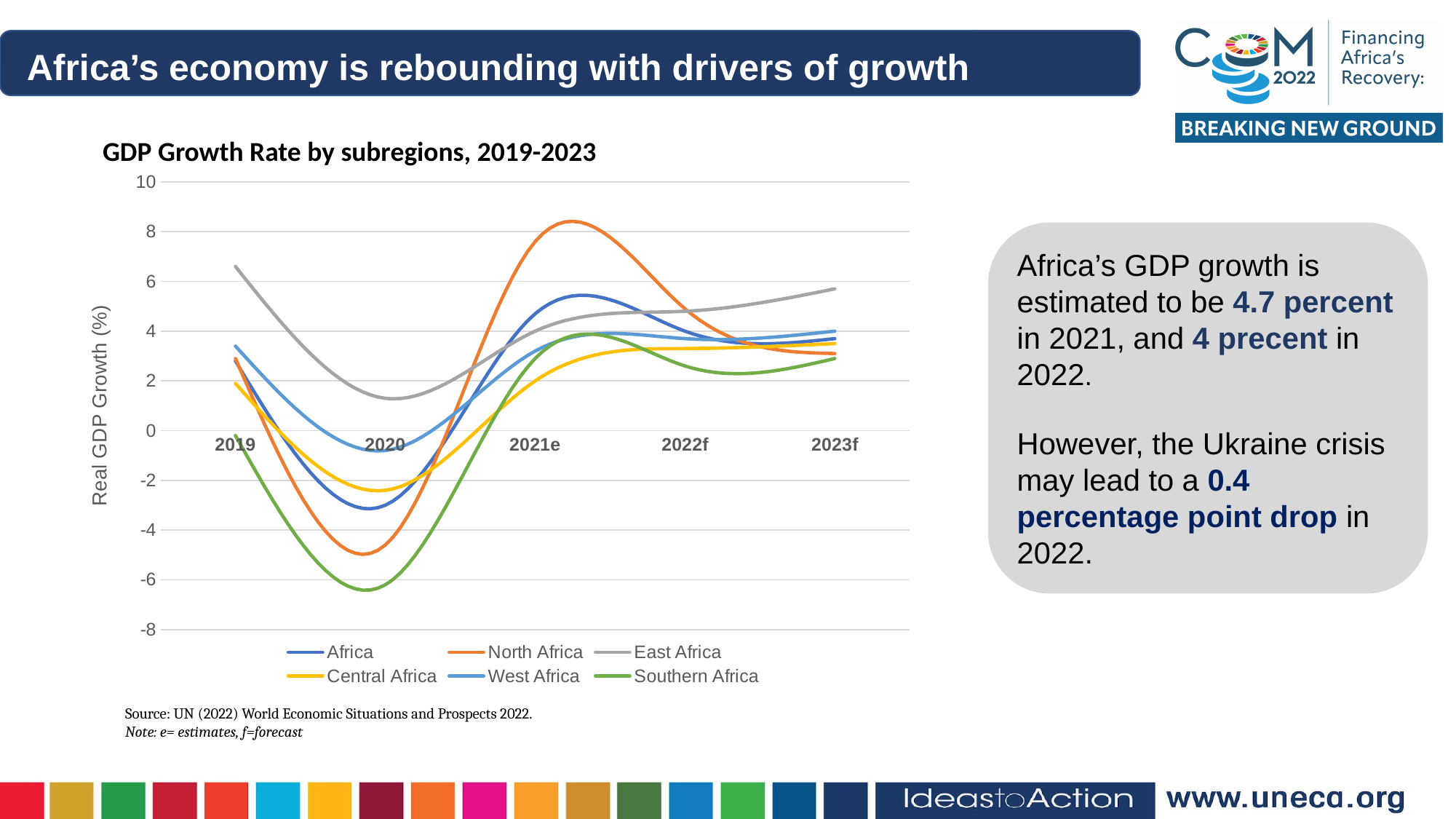
Is the value for Southern Africa in 2020 greater or less than -4? less Which subregion has the highest GDP growth rate in 2021e? North Africa Is the value for East Africa in 2020 greater or less than 0? greater Is the value for North Africa in 2021e greater or less than 6? greater What is the label of the y axis? Real GDP Growth (%) Does the East Africa line rise or fall from 2021e to 2023f? rise What kind of chart is shown on the slide? line chart Which subregion has the lowest GDP growth rate in 2020? Southern Africa How many series does the legend list? 6 What is the title of the chart? GDP Growth Rate by subregions, 2019-2023 How many years are shown on the x axis? 5 Which series has the highest value in 2019? East Africa